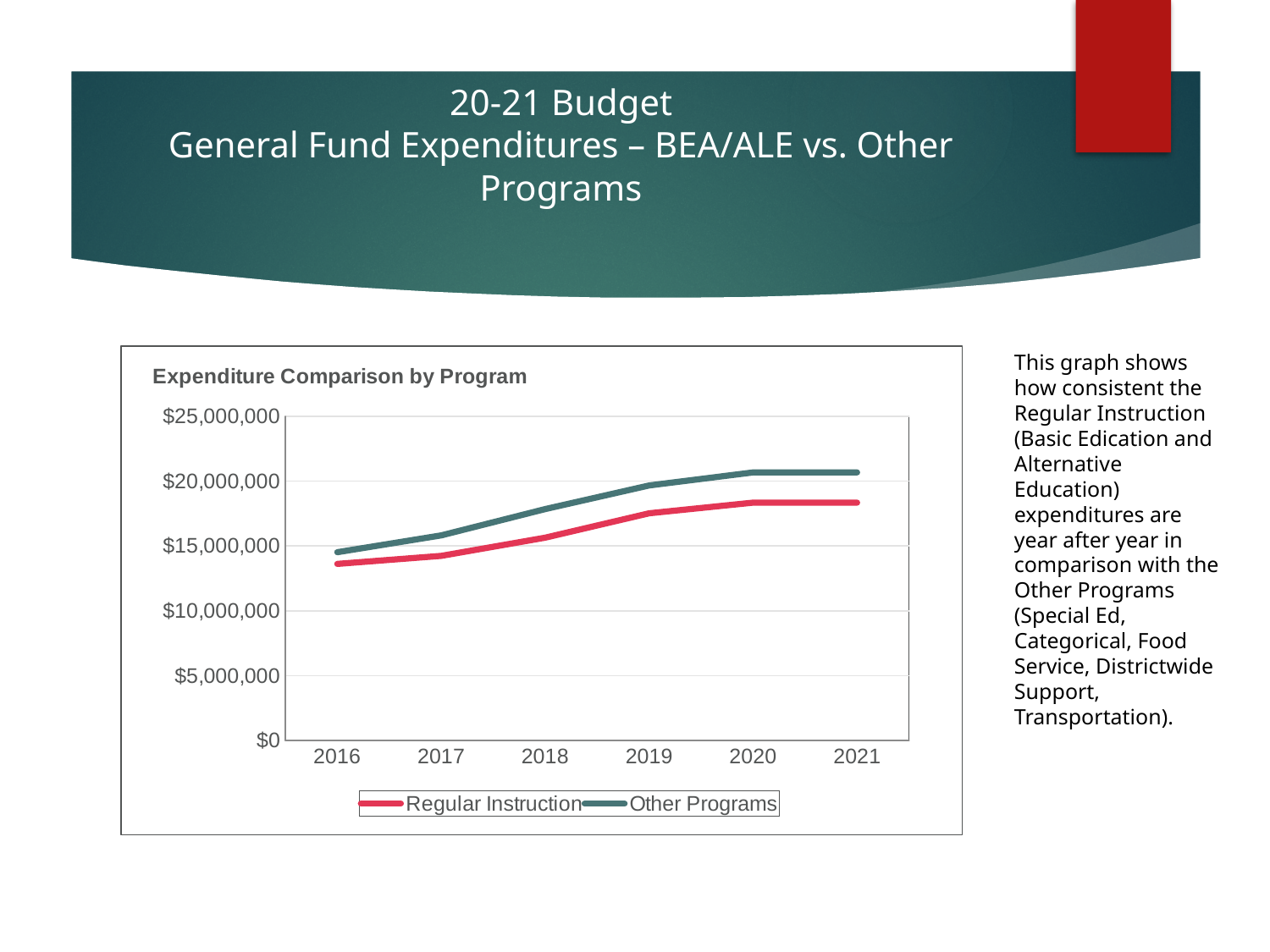
How many years are plotted along the x axis of the chart? 6 In 2019, which series has the higher value, Regular Instruction or Other Programs? Other Programs Is the value for Other Programs in 2018 greater or less than $15,000,000? greater Do the Regular Instruction values generally rise or fall from 2016 to 2021? rise How many series does the chart legend list? 2 Which series is drawn in red in the chart? Regular Instruction Is the value for Regular Instruction in 2021 greater or less than $20,000,000? less What is the title of the chart? Expenditure Comparison by Program Is the value for Other Programs in 2020 greater or less than $20,000,000? greater In which year is the Other Programs value lowest? 2016 What kind of chart is shown on the slide? line chart